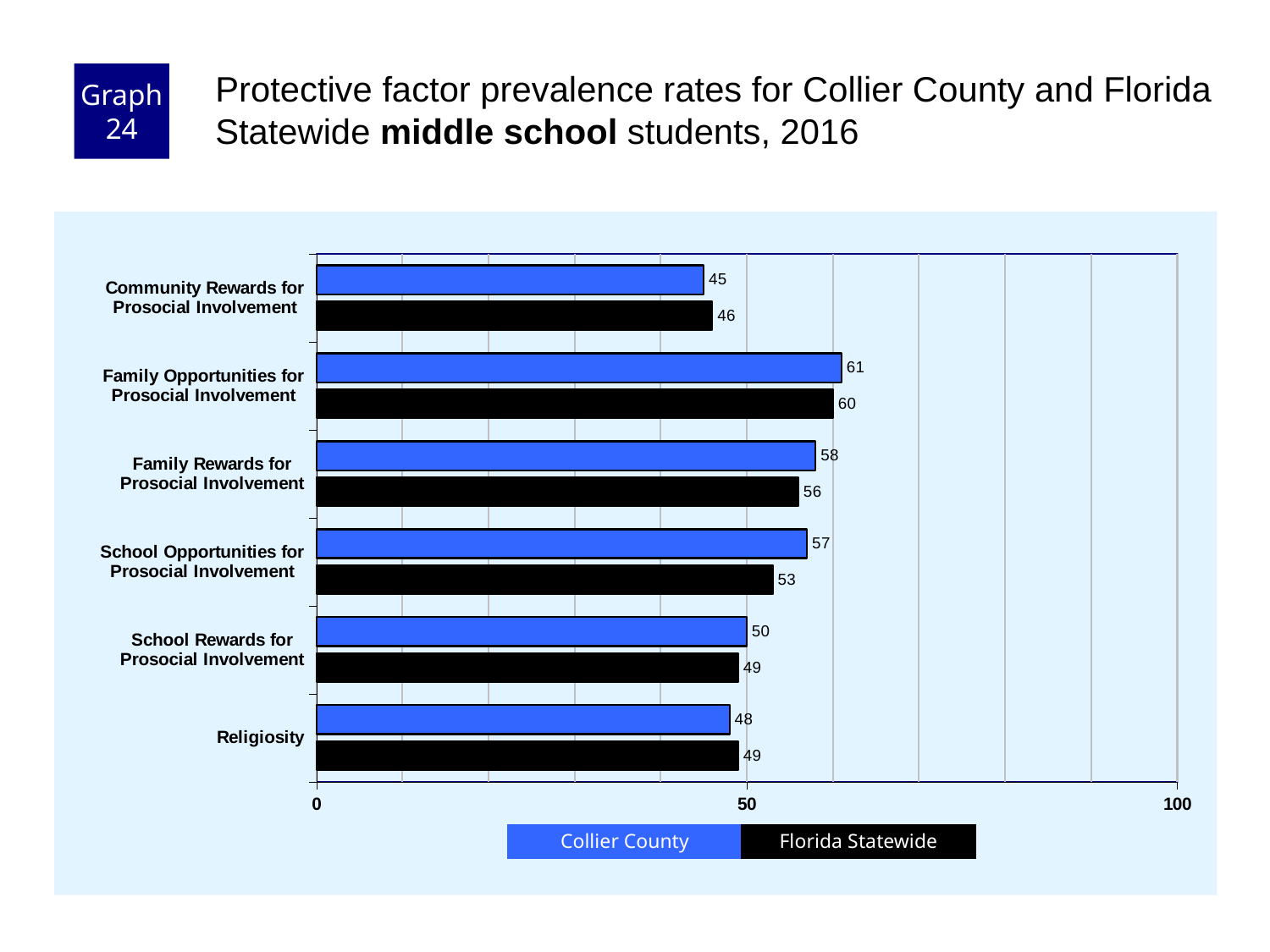
For Family Rewards for Prosocial Involvement, which is larger: the Collier County value or the Florida Statewide value? Collier County What kind of chart is shown on the slide? bar chart What is the Florida Statewide value for Religiosity? 49 Which colour represents Florida Statewide in the chart? black What is the Florida Statewide value for School Opportunities for Prosocial Involvement? 53 Is the Florida Statewide value for Community Rewards for Prosocial Involvement greater or less than 50? less What is the difference between the Collier County and Florida Statewide values for School Opportunities for Prosocial Involvement? 4 How many series does the legend list? 2 How many protective factor categories are shown on the chart? 6 What is the Collier County value for Family Opportunities for Prosocial Involvement? 61 Which category has the highest Collier County value? Family Opportunities for Prosocial Involvement Which category has the lowest Collier County value? Community Rewards for Prosocial Involvement